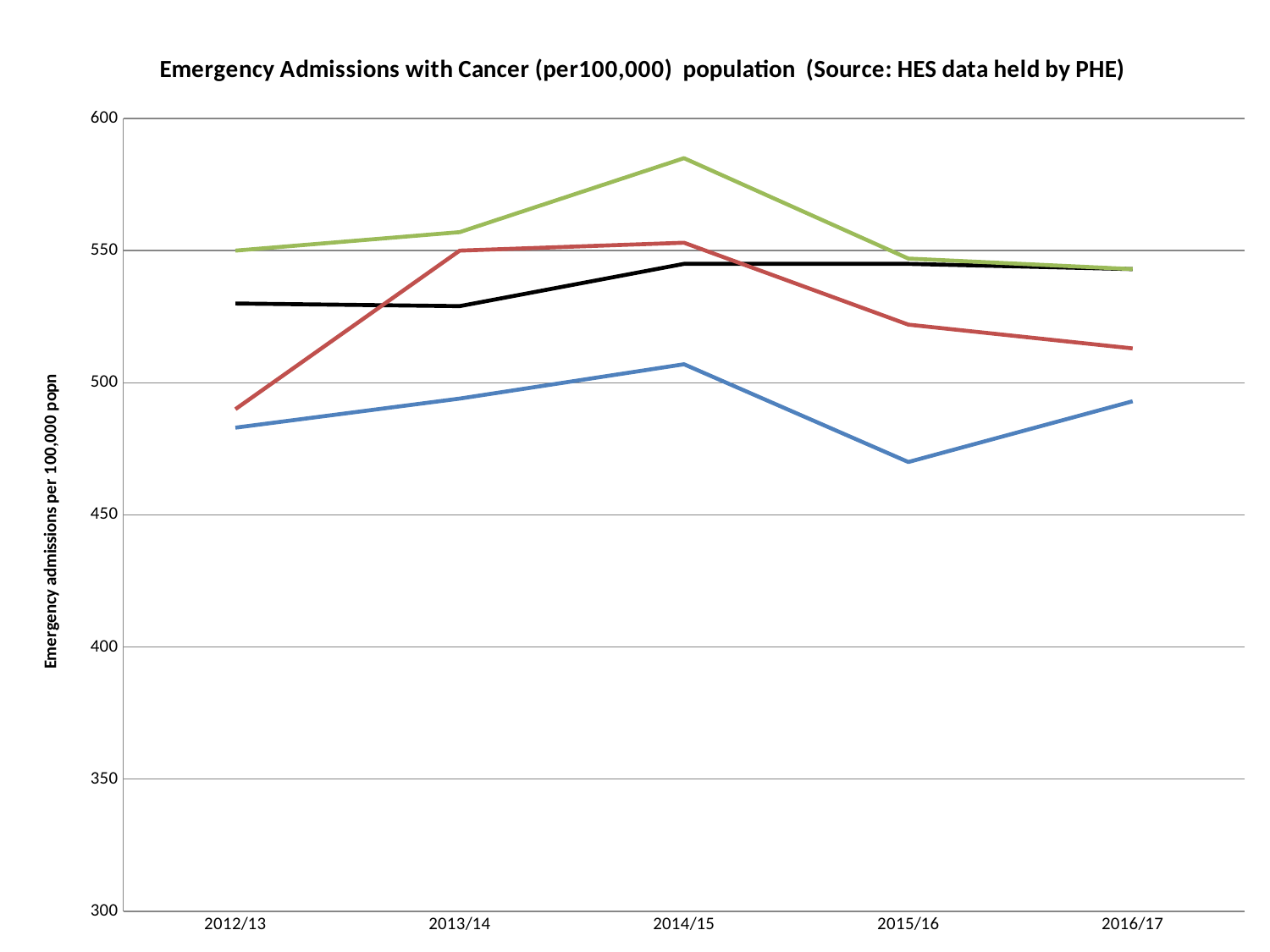
What is the label of the vertical axis? Emergency admissions per 100,000 popn Which coloured line has the highest value in 2014/15? green What is the title of the chart? Emergency Admissions with Cancer (per100,000) population (Source: HES data held by PHE) Which coloured line has the lowest value in 2015/16? blue Is the value of the blue line in 2015/16 greater or less than 500? less Is the value of the green line in 2014/15 greater or less than 550? greater Does the blue line rise or fall between 2012/13 and 2014/15? rise Is the value of the red line in 2012/13 greater or less than 500? less In 2016/17, which is larger: the value of the black line or the value of the red line? black line Does the red line rise or fall between 2014/15 and 2016/17? fall How many time periods are shown on the x axis? 5 What type of chart is shown on the slide? line chart